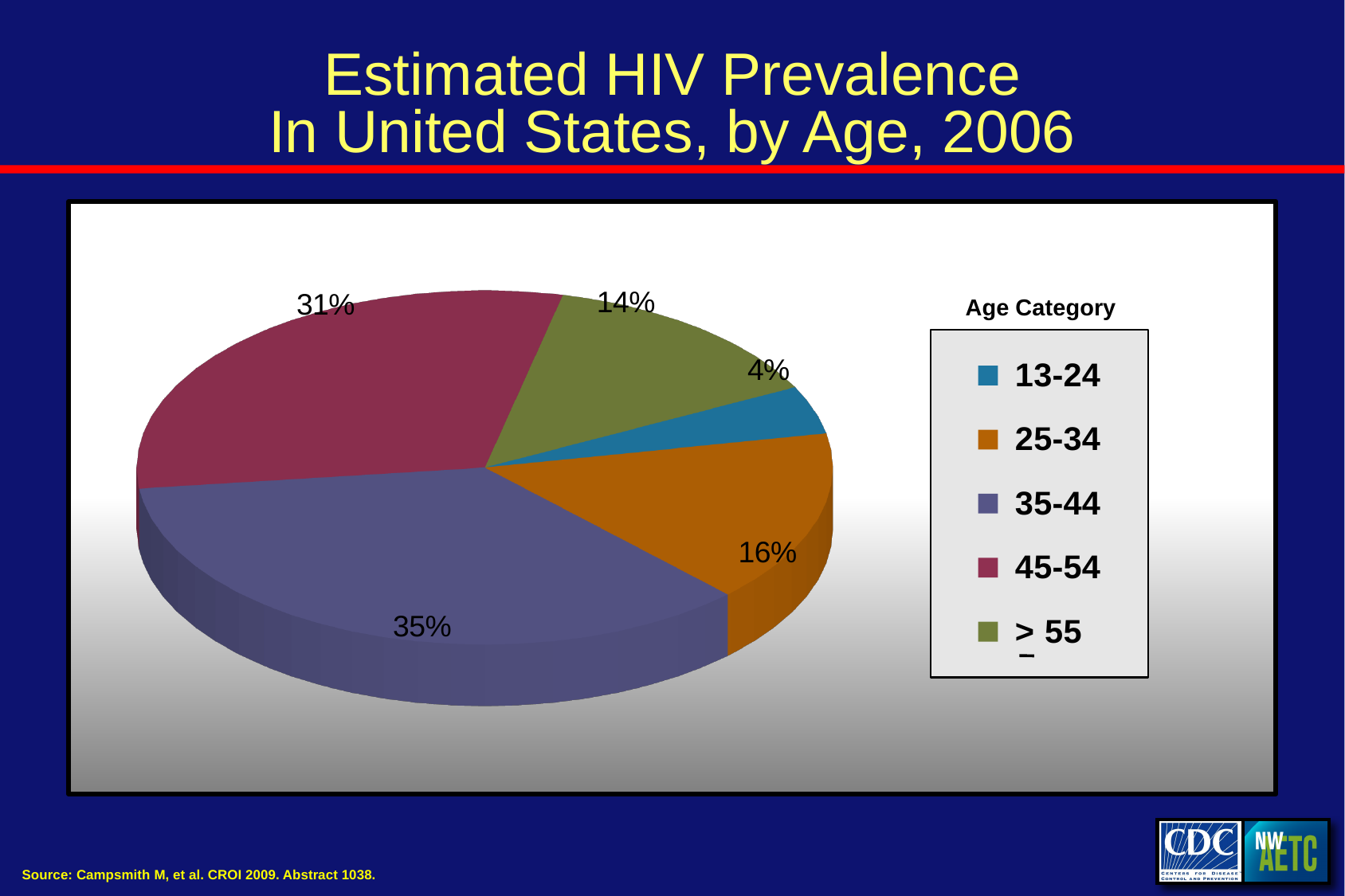
What percentage of estimated HIV prevalence is in the 55 and older age category? 14% Which age category has a larger share, 25-34 or 55 and older? 25-34 What percentage of estimated HIV prevalence is in the 35-44 age category? 35% What is the difference in percentage points between the 35-44 and 45-54 age categories? 4 Which age category has the smallest share of estimated HIV prevalence? 13-24 How many age categories are shown in the pie chart? 5 Which age category has the largest share of estimated HIV prevalence? 35-44 What percentage of estimated HIV prevalence is in the 45-54 age category? 31% What is the title of the legend in the chart? Age Category What percentage of estimated HIV prevalence is in the 13-24 age category? 4% What percentage of estimated HIV prevalence is in the 25-34 age category? 16% What type of chart is shown on the slide? Pie chart